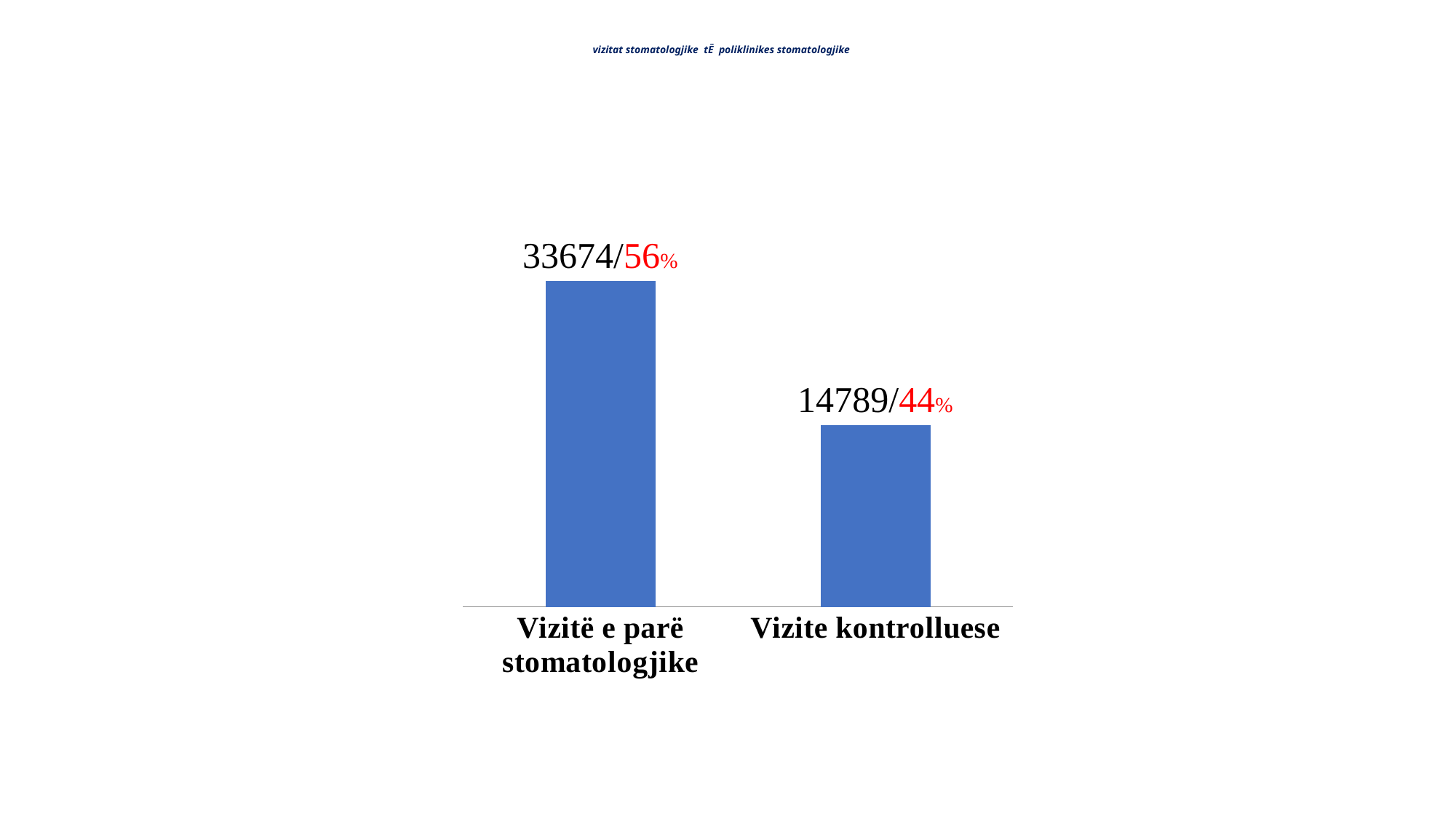
What percentage is shown for Vizitë e parë stomatologjike? 56% Which is larger, the value for Vizitë e parë stomatologjike or the value for Vizite kontrolluese? Vizitë e parë stomatologjike What is the difference between the count for Vizitë e parë stomatologjike (33674) and the count for Vizite kontrolluese (14789)? 18885 What is the data label shown on the bar for Vizite kontrolluese? 14789/44% Which category has the lowest value? Vizite kontrolluese By how many percentage points does the share for Vizitë e parë stomatologjike exceed the share for Vizite kontrolluese? 12 What is the data label shown on the bar for Vizitë e parë stomatologjike? 33674/56% How many categories are shown in the chart? 2 Which category has the highest value? Vizitë e parë stomatologjike What colour are the bars in the chart? Blue What kind of chart is shown on the slide? Bar chart What percentage is shown for Vizite kontrolluese? 44%